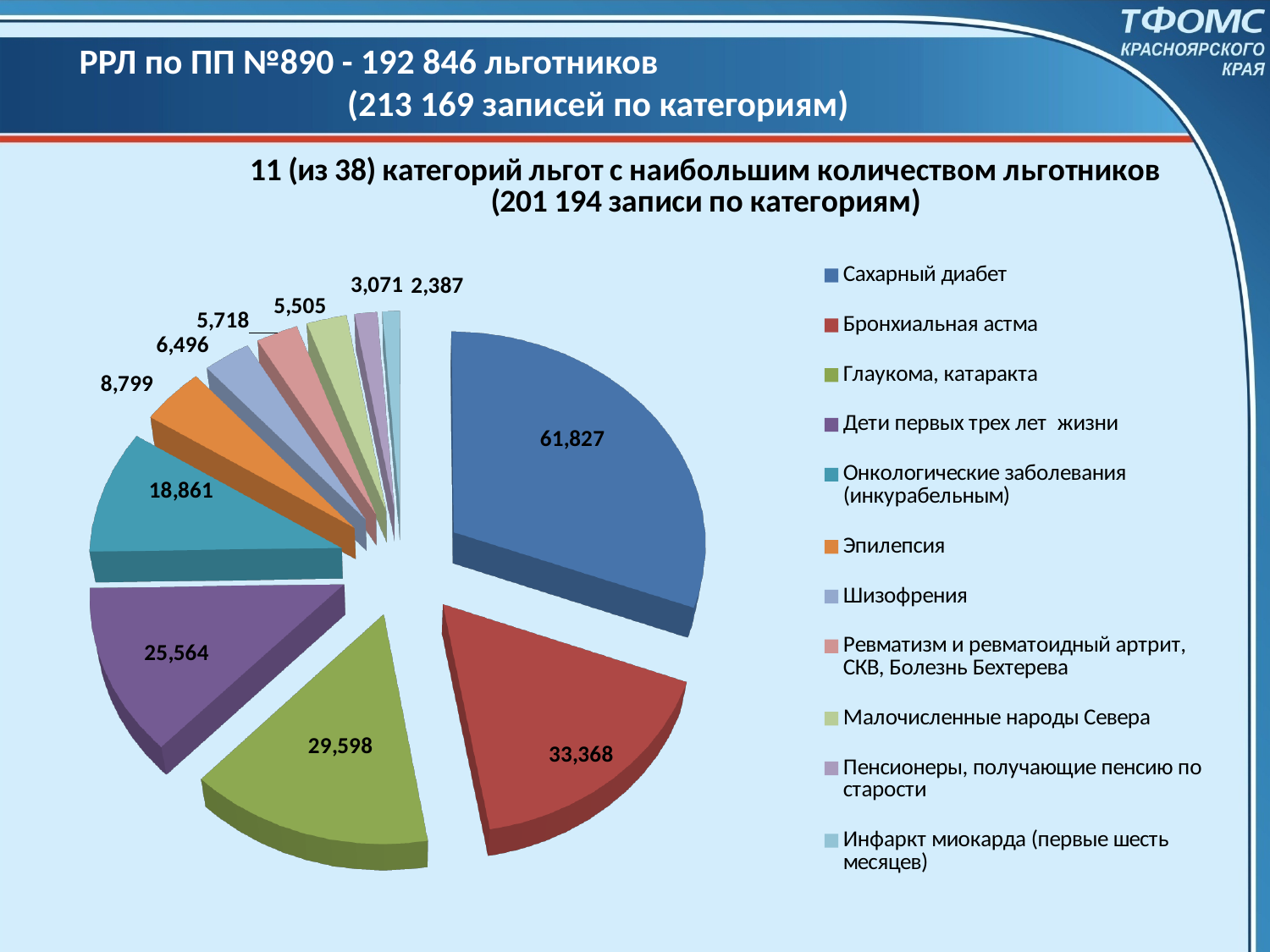
Which is larger, the value for Дети первых трех лет жизни or the value for Онкологические заболевания (инкурабельным)? Дети первых трех лет жизни What is the value for Бронхиальная астма? 33,368 What is the difference between the values for Бронхиальная астма and Глаукома, катаракта? 3,770 What kind of chart is shown on the slide? Pie chart Which category has the largest slice of the pie? Сахарный диабет What is the value for Сахарный диабет? 61,827 What is the value for Инфаркт миокарда (первые шесть месяцев)? 2,387 What is the title of the chart? 11 (из 38) категорий льгот с наибольшим количеством льготников (201 194 записи по категориям) How many entries does the legend list? 11 What is the value for Онкологические заболевания (инкурабельным)? 18,861 How many categories does the pie chart show? 11 Which category has the smallest slice of the pie? Инфаркт миокарда (первые шесть месяцев)